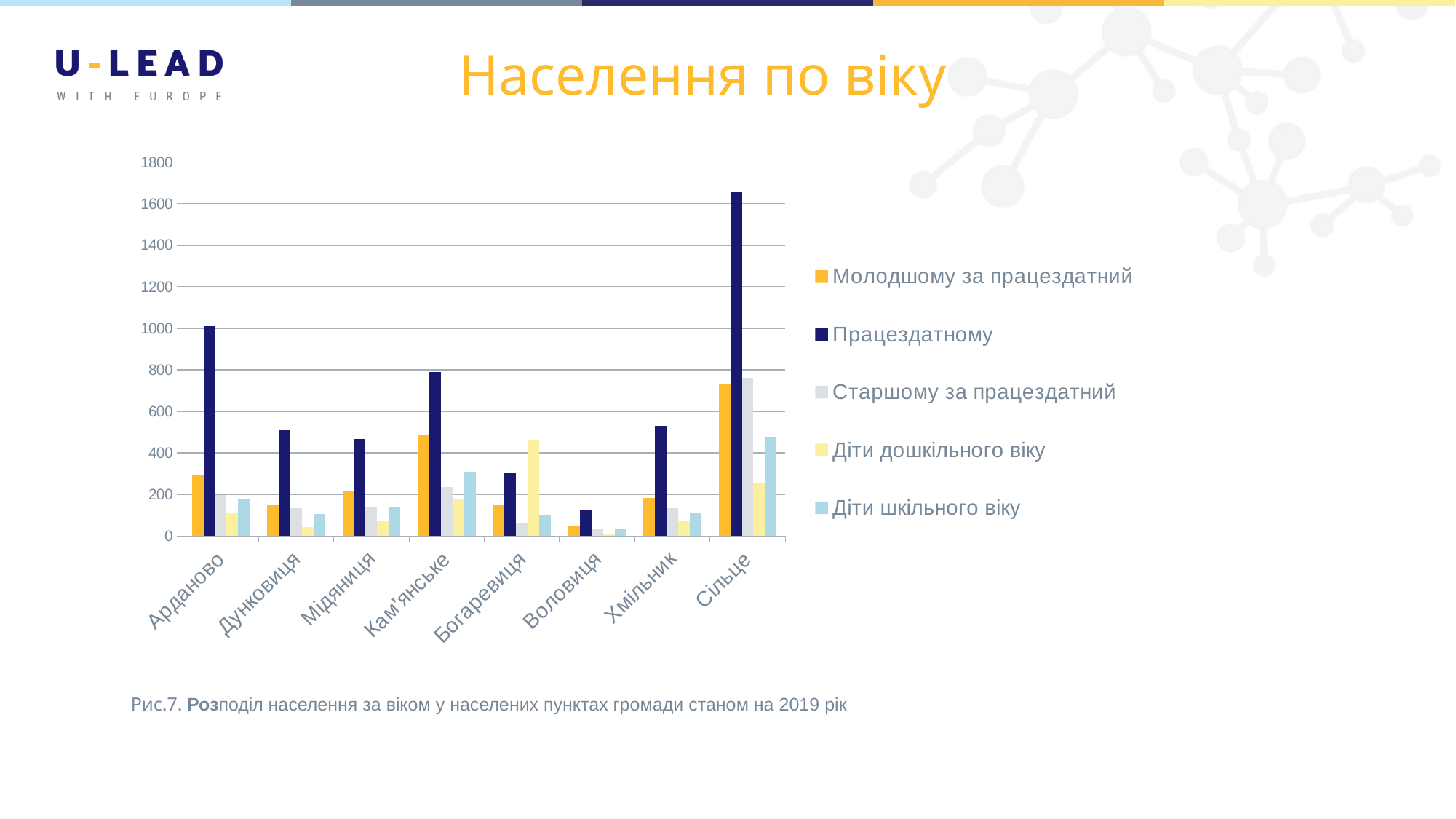
Which settlement has the lowest value for Молодшому за працездатний? Воловиця Is the value for Працездатному in Сільце greater or less than 1600? greater In Богаревиця, which is larger: the value for Діти дошкільного віку or the value for Працездатному? Діти дошкільного віку Which settlement has the lowest value for Працездатному? Воловиця Is the value for Працездатному in Воловиця greater or less than 200? less What is the title of the slide containing the chart? Населення по віку What kind of chart is shown on the slide? bar chart Which settlement has the highest value for Молодшому за працездатний? Сільце Which settlement has the highest value for Працездатному? Сільце How many settlements (categories) are shown on the x axis of the chart? 8 Is the value for Працездатному in Арданово greater or less than 800? greater How many series does the chart legend list? 5